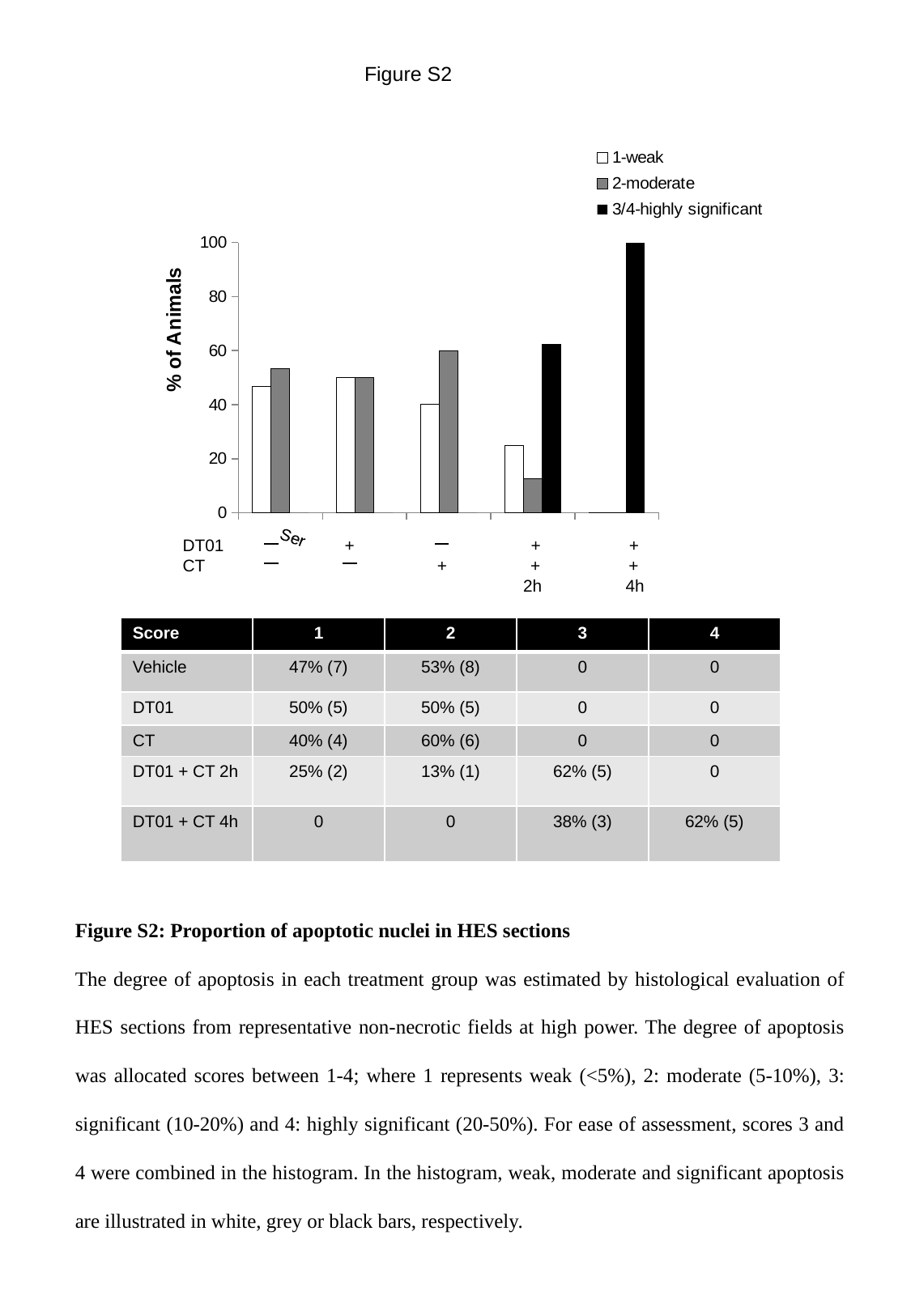
Is the 3/4-highly significant bar for the DT01 + CT 2h group greater or less than 40? greater Does the 3/4-highly significant series rise or fall moving from left to right along the x axis? rises Is the 1-weak bar for the vehicle group (DT01 −, CT −) greater or less than 40? greater Which treatment group has the tallest bar in the chart? DT01 + CT 4h What kind of chart is shown in Figure S2? bar chart Is the 1-weak bar for the DT01 + CT 2h group greater or less than 40? less What is the title of the y axis of the chart? % of Animals What is the value of the 3/4-highly significant bar for the DT01 + CT 4h group? 100 For the CT-only group (DT01 −, CT +), which bar is taller: 1-weak or 2-moderate? 2-moderate How many series does the legend of the chart list? 3 How many treatment groups (categories) are plotted along the x axis of the chart? 5 What is the value of the 2-moderate bar for the CT-only group (DT01 −, CT +)? 60